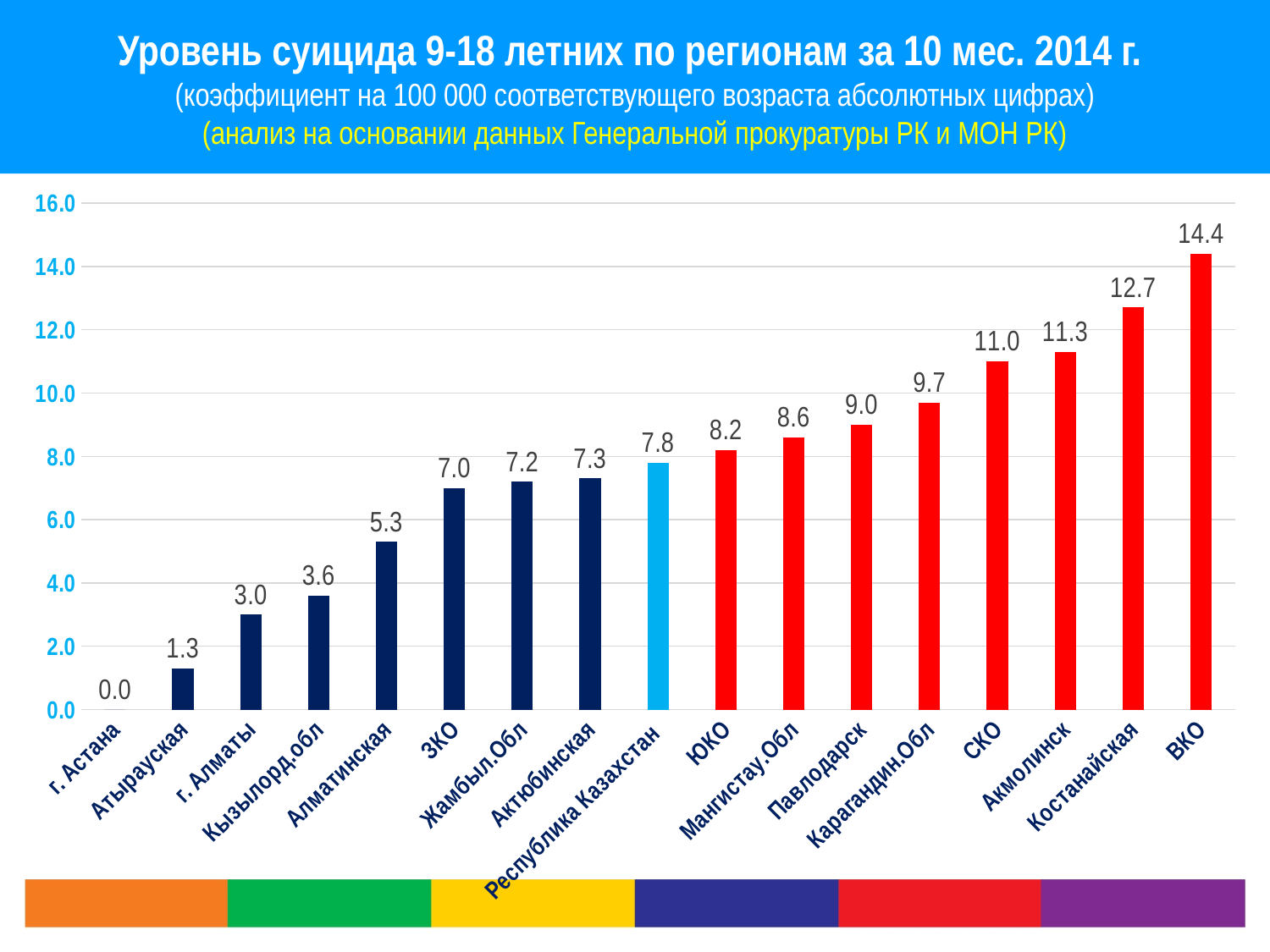
What is the value for ВКО? 14.4 Which region has the highest value? ВКО Which category has the lowest value? г. Астана What is the difference between the values for СКО and ЗКО? 4.0 What is the difference between the values for ВКО and Костанайская? 1.7 Which is larger, the value for Павлодарск or the value for Мангистау.Обл? Павлодарск What is the value for Алматинская? 5.3 What kind of chart is shown on the slide? bar chart Do the values rise or fall from left to right along the x axis? rise What is the value for Республика Казахстан? 7.8 Is the value for Карагандин.Обл greater or less than 10.0? less How many categories are shown on the x axis? 17